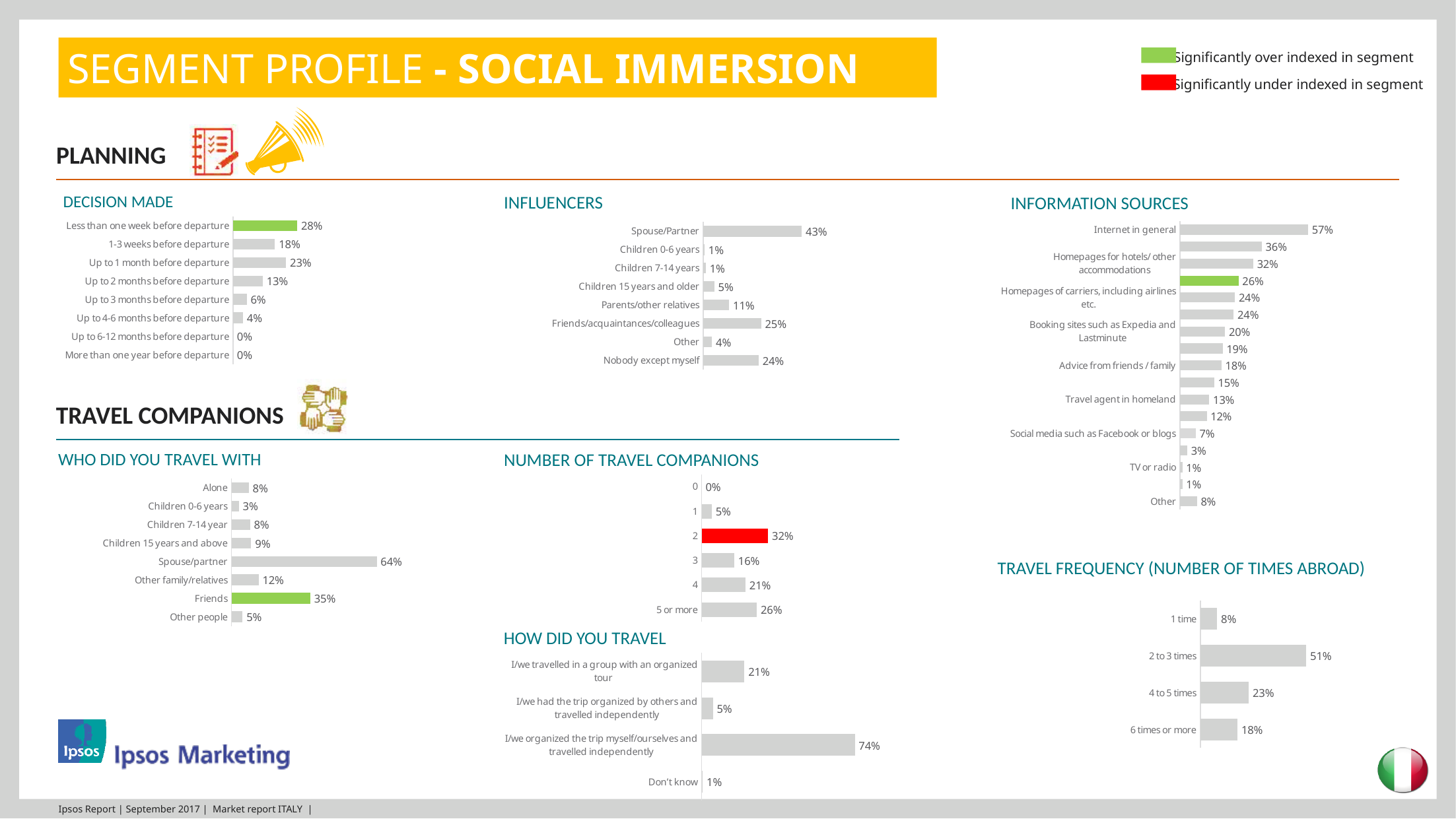
In the How Did You Travel chart, what is the value for 'I/we organized the trip myself/ourselves and travelled independently'? 74% In the Influencers chart, what is the value for 'Spouse/Partner'? 43% What type of chart is the Travel Frequency (Number of Times Abroad) chart? Bar chart In the Who Did You Travel With chart, what is the value for 'Spouse/partner'? 64% In the Who Did You Travel With chart, which is larger, 'Friends' or 'Other family/relatives'? Friends In the Decision Made chart, how many categories are shown? 8 In the Decision Made chart, which category has the highest value? Less than one week before departure In the Information Sources chart, which category has the highest value? Internet in general In the Decision Made chart, what is the value for 'Less than one week before departure'? 28% In the Number of Travel Companions chart, what is the value for '2'? 32% In the Travel Frequency (Number of Times Abroad) chart, which category has the lowest value? 1 time In the Influencers chart, what is the difference between 'Friends/acquaintances/colleagues' and 'Nobody except myself'? 1%